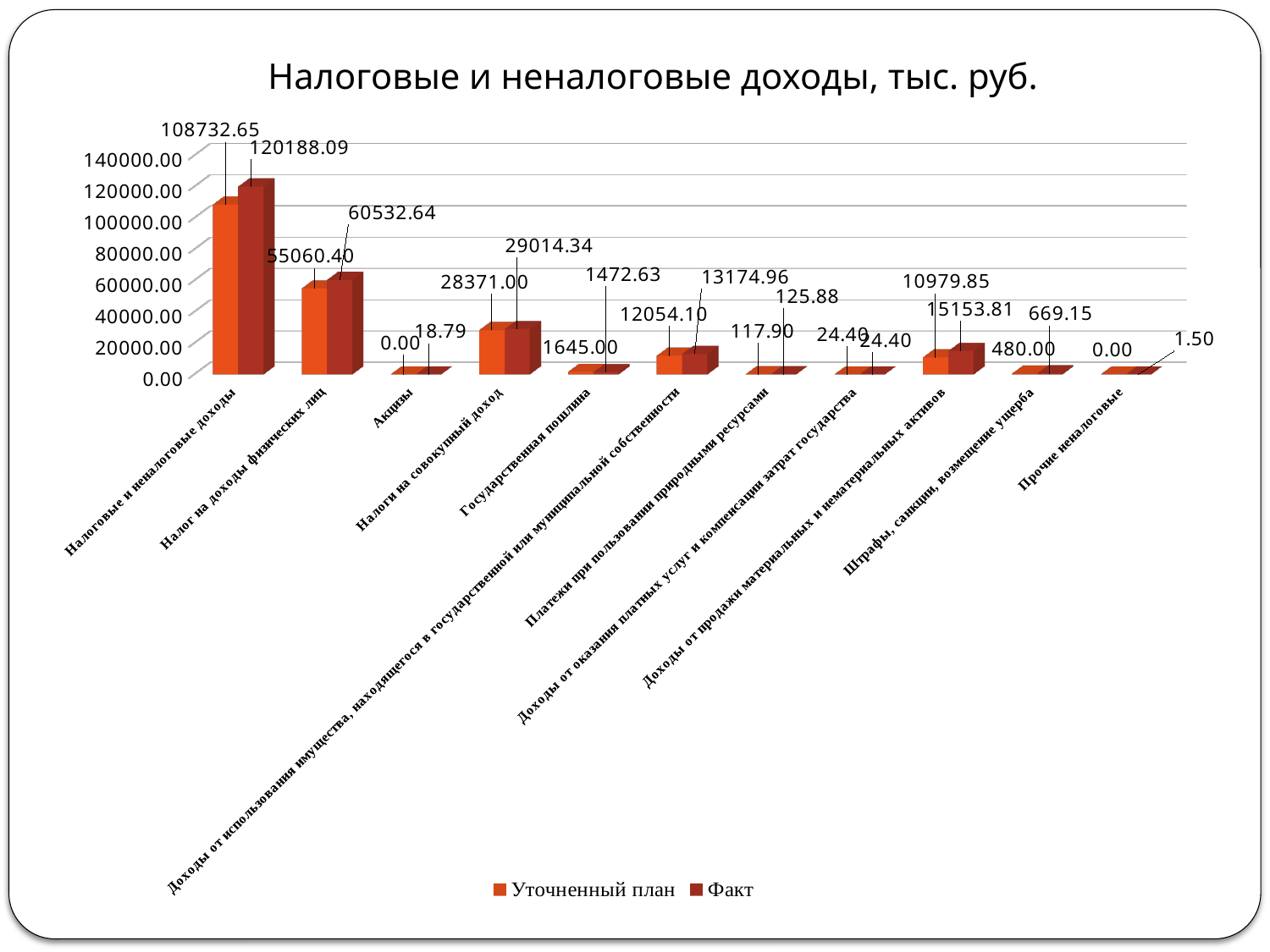
What is the title of the chart? Налоговые и неналоговые доходы, тыс. руб. How many series does the legend list? 2 What is the difference between the Факт and Уточненный план values for Налоговые и неналоговые доходы? 11455.44 Which category has the highest Факт value? Налоговые и неналоговые доходы What kind of chart is shown on the slide? Bar chart What is the Факт value for Налог на доходы физических лиц? 60532.64 For Государственная пошлина, which is larger: Уточненный план or Факт? Уточненный план Which category has the lowest Факт value? Прочие неналоговые What is the Факт value for Штрафы, санкции, возмещение ущерба? 669.15 What is the Уточненный план value for Акцизы? 0.00 What is the Уточненный план value for Налоги на совокупный доход? 28371.00 How many categories are shown on the x axis? 11